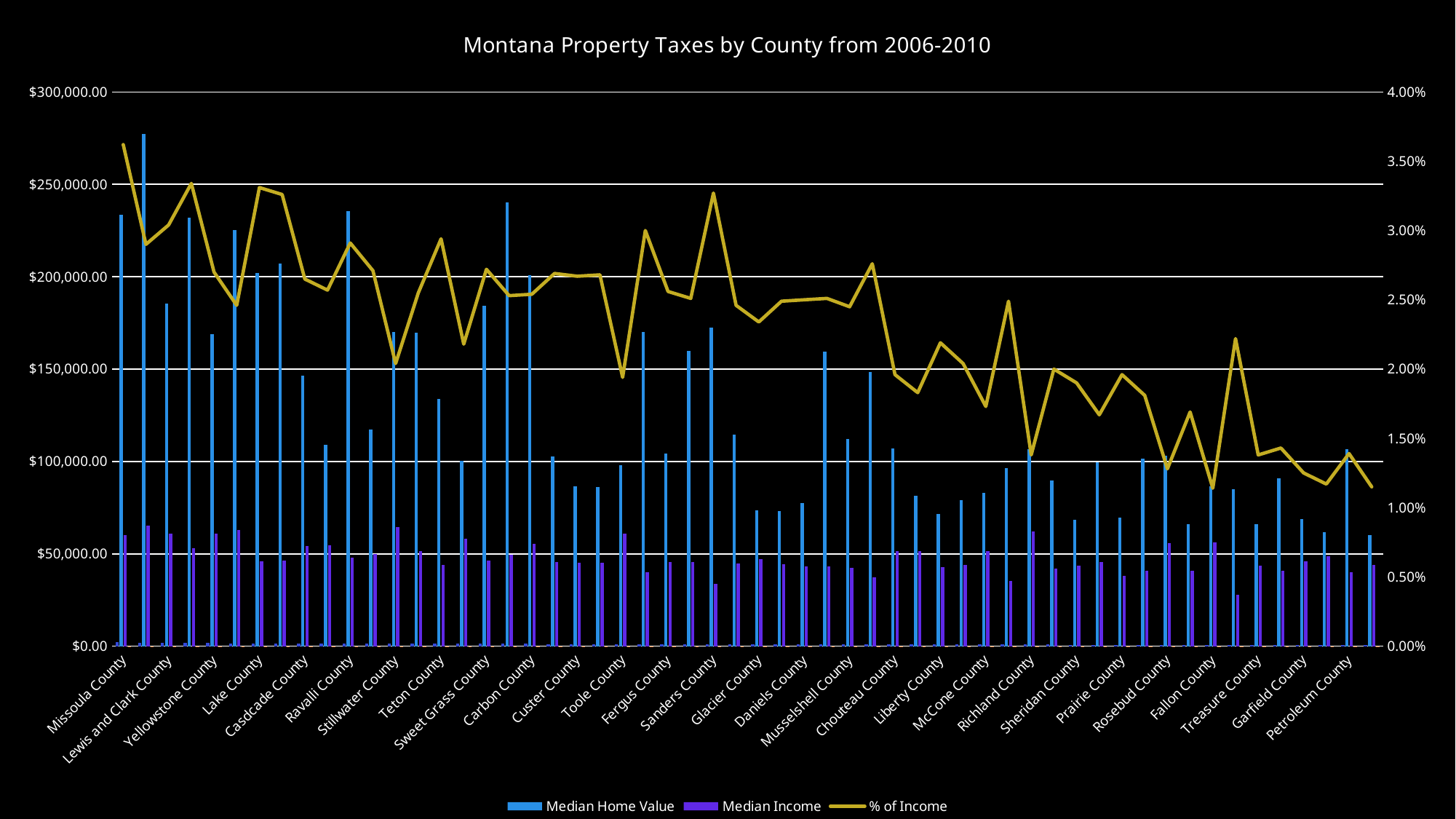
Is the % of Income for Petroleum County greater or less than 1.50%? less Is the Median Home Value for Missoula County greater or less than $200,000.00? greater Is the Median Home Value for Lewis and Clark County greater or less than $150,000.00? greater Do the Median Home Value bars generally rise or fall from left to right across the counties? fall How many series does the legend list? 3 What is the title of the chart? Montana Property Taxes by County from 2006-2010 Which county has the larger Median Home Value, Missoula County or Petroleum County? Missoula County What kind of chart is this? Combined bar and line chart Which series is drawn as a line rather than bars? % of Income